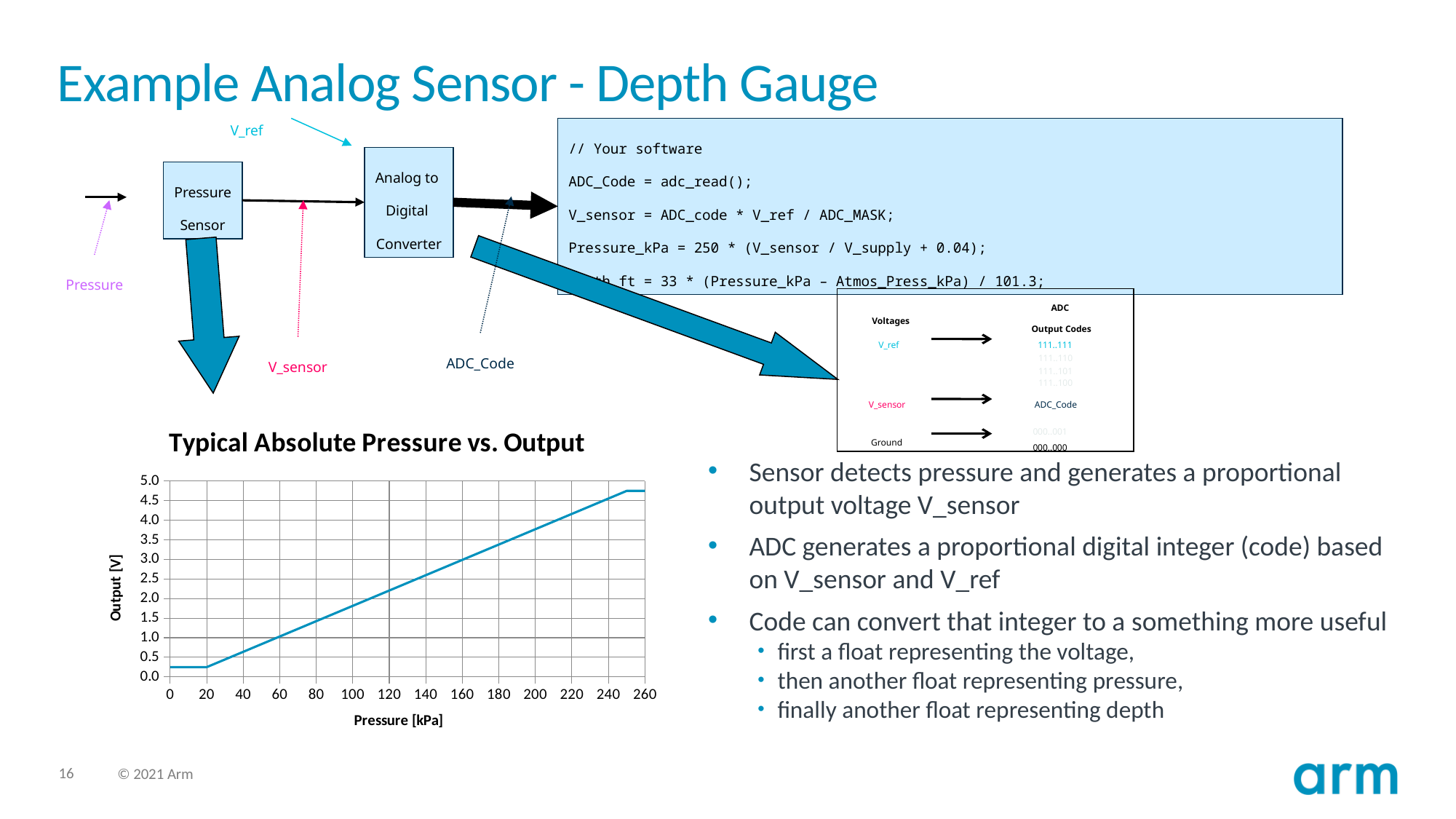
What is the title of the chart on the slide? Typical Absolute Pressure vs. Output In the 'Typical Absolute Pressure vs. Output' chart, is the output at 100 kPa greater or less than 2.0 V? less In the 'Typical Absolute Pressure vs. Output' chart, which is larger: the output at 80 kPa or the output at 180 kPa? 180 kPa In the 'Typical Absolute Pressure vs. Output' chart, is the output at 260 kPa greater or less than 4.5 V? greater In the 'Typical Absolute Pressure vs. Output' chart, is the output at 100 kPa greater or less than 1.5 V? greater What is the x-axis title of the 'Typical Absolute Pressure vs. Output' chart? Pressure [kPa] In the 'Typical Absolute Pressure vs. Output' chart, does the output voltage rise or fall as pressure increases from 20 kPa to 240 kPa? rise What kind of chart is 'Typical Absolute Pressure vs. Output'? line chart